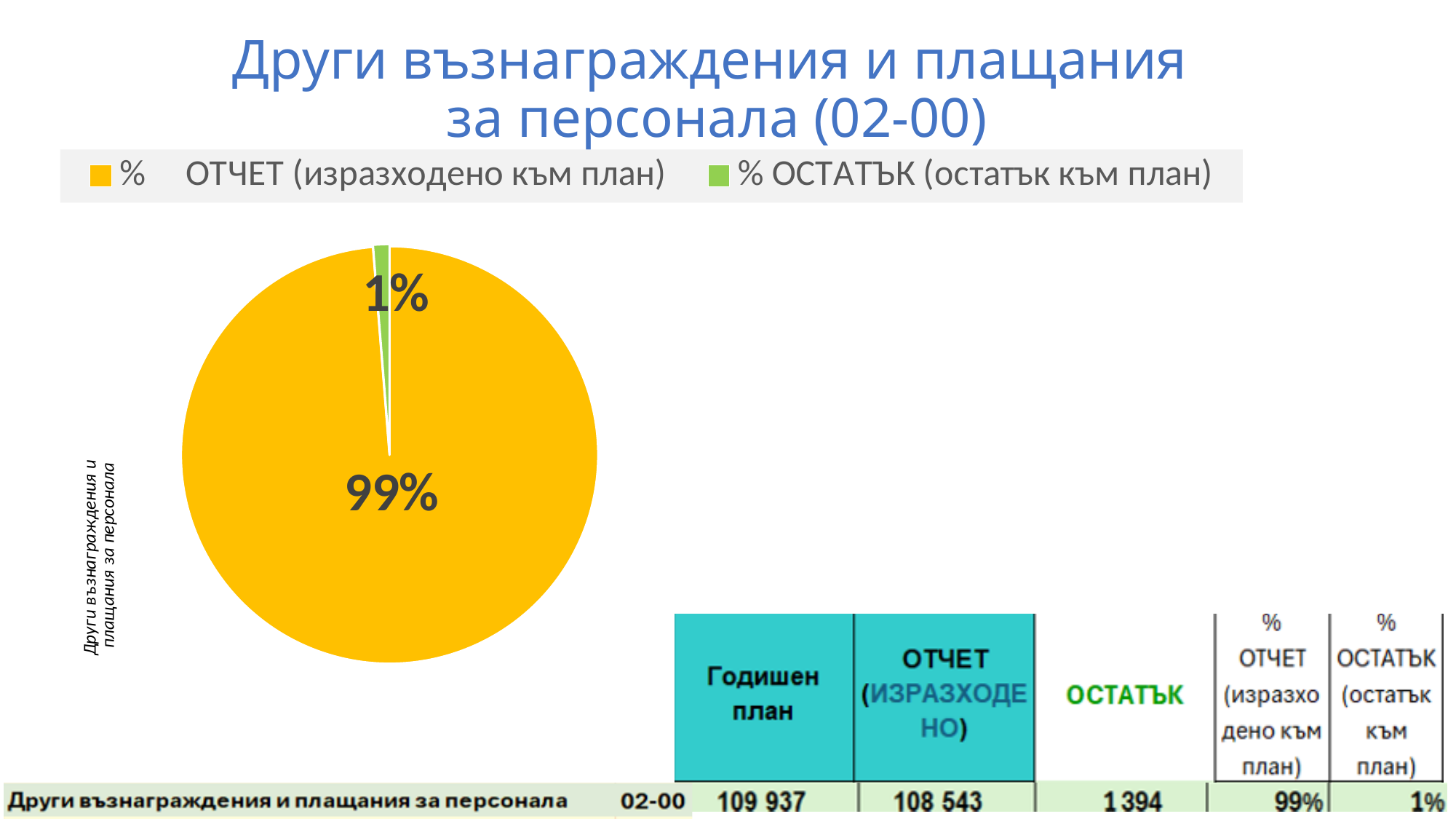
What colour is the "% ОСТАТЪК (остатък към план)" slice in the pie chart? Green What share of the pie does the slice "% ОТЧЕТ (изразходено към план)" take? 99% What is the difference in percentage points between the "% ОТЧЕТ" slice and the "% ОСТАТЪК" slice? 98 What kind of chart is shown on the slide? Pie chart What share of the pie does the slice "% ОСТАТЪК (остатък към план)" take? 1% What is the title of the slide containing the pie chart? Други възнаграждения и плащания за персонала (02-00) How many slices does the pie chart have? 2 How many entries does the legend list? 2 Which is larger: the "% ОТЧЕТ (изразходено към план)" slice or the "% ОСТАТЪК (остатък към план)" slice? % ОТЧЕТ (изразходено към план) Which slice of the pie is the smallest? % ОСТАТЪК (остатък към план) Which slice of the pie is the largest? % ОТЧЕТ (изразходено към план)